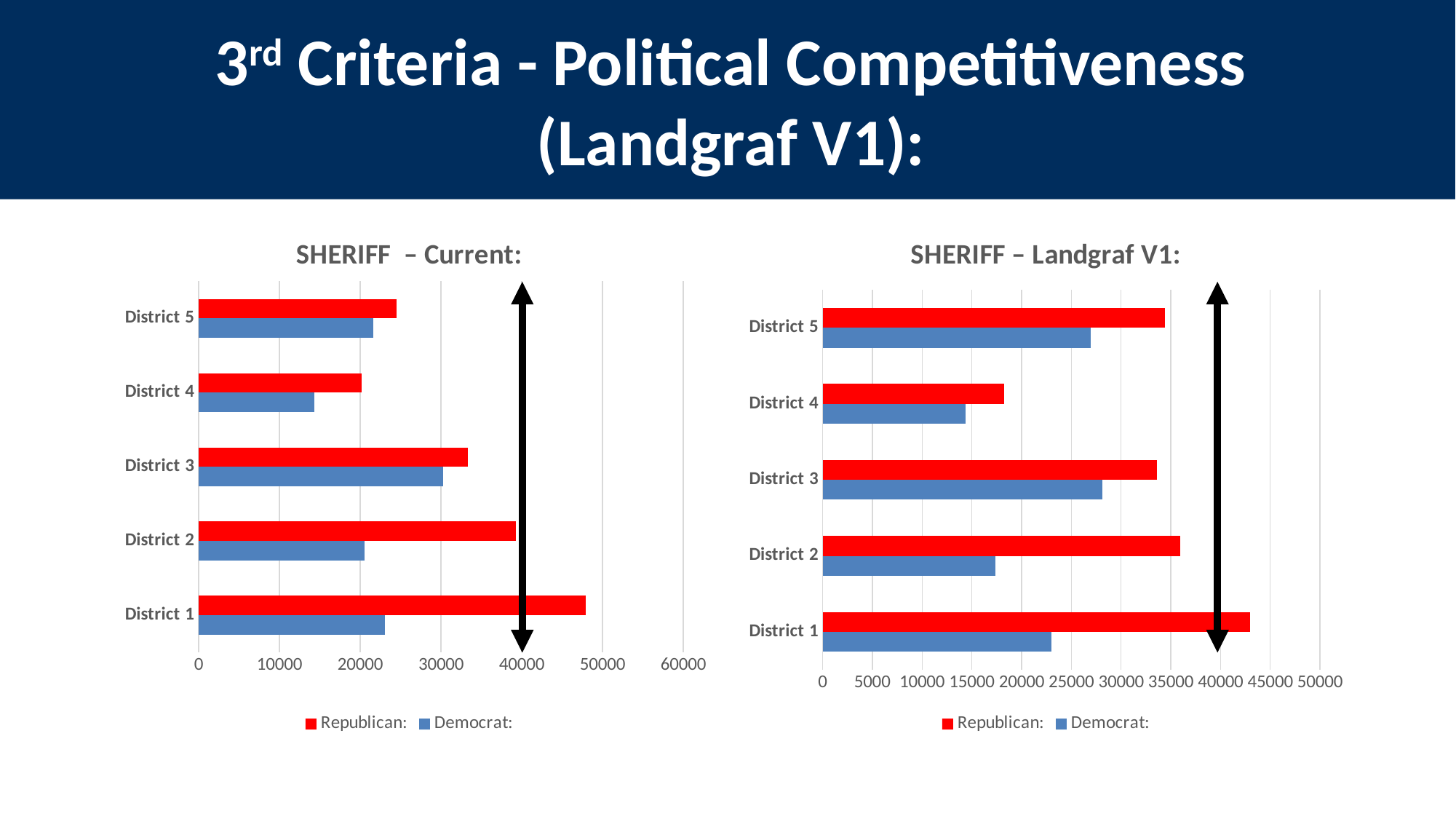
In the 'SHERIFF – Current:' chart, what colour represents the Republican series? red What kind of chart is the 'SHERIFF – Current:' chart? bar chart In the 'SHERIFF – Current:' chart, is the Democrat value for District 4 greater or less than 20000? less How many districts are shown in the 'SHERIFF – Current:' chart? 5 In the 'SHERIFF – Landgraf V1:' chart, which district has the highest Republican value? District 1 In the 'SHERIFF – Landgraf V1:' chart, which is larger for District 2, the Republican value or the Democrat value? Republican In the 'SHERIFF – Landgraf V1:' chart, is the Republican value for District 1 greater or less than 40000? greater In the 'SHERIFF – Current:' chart, which district has the highest Republican value? District 1 How many series does the legend of the 'SHERIFF – Landgraf V1:' chart list? 2 In the 'SHERIFF – Landgraf V1:' chart, which district has the lowest Republican value? District 4 In the 'SHERIFF – Current:' chart, which district has the lowest Democrat value? District 4 In the 'SHERIFF – Current:' chart, is the Republican value for District 1 greater or less than 40000? greater